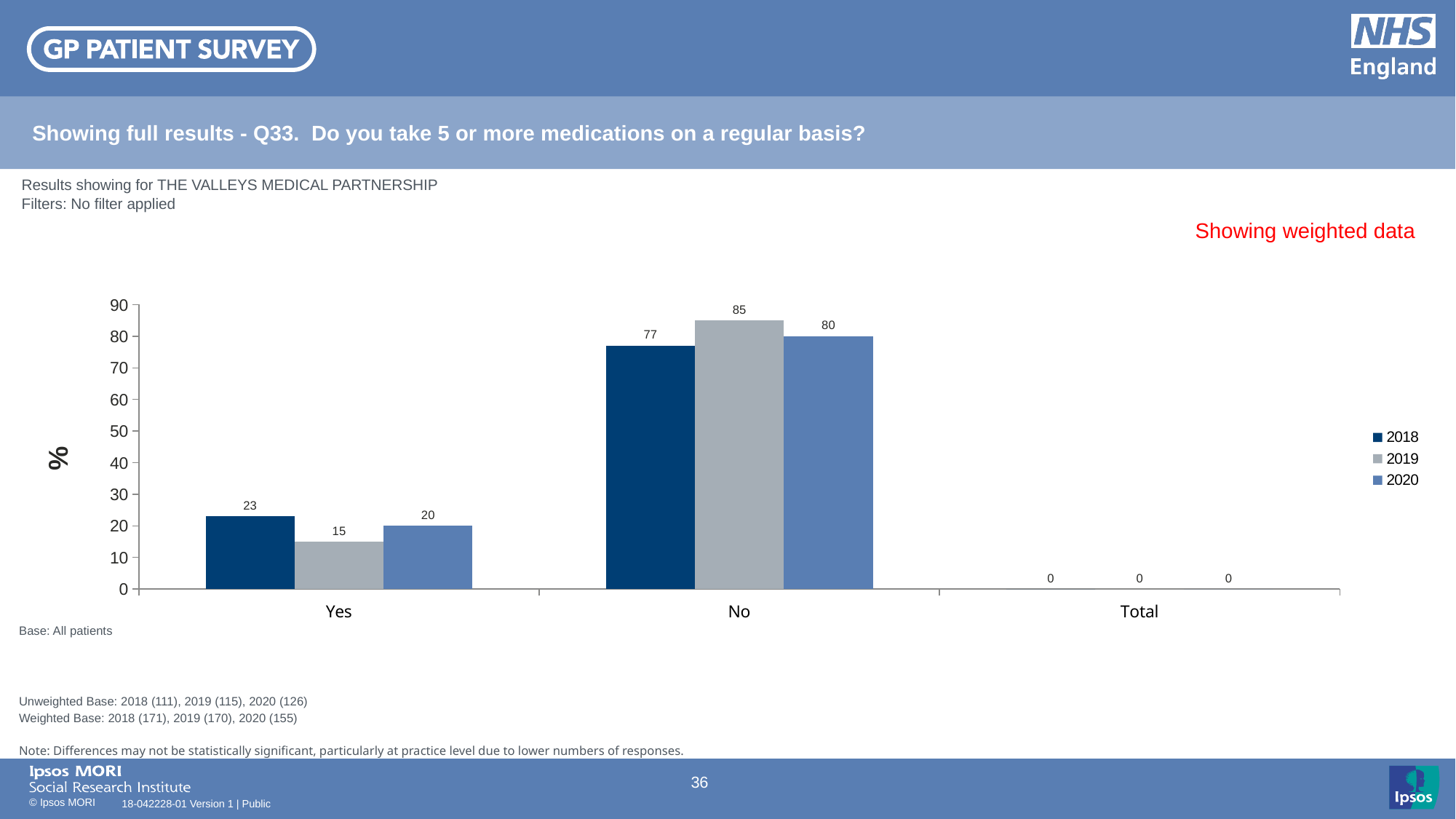
How many categories are shown on the x axis? 3 What kind of chart is shown on the slide? Bar chart What is the value for 'No' in 2019? 85 What is the value for 'Yes' in 2018? 23 What is the value for 'Yes' in 2020? 20 What is the difference between the 'No' values for 2019 and 2018? 8 Which year has the lowest value for 'Yes'? 2019 Which year has the highest value for 'No'? 2019 What is the label on the vertical axis? % Which is larger: the 'Yes' value for 2018 or for 2020? 2018 What is the value for 'No' in 2020? 80 How many series does the legend list? 3